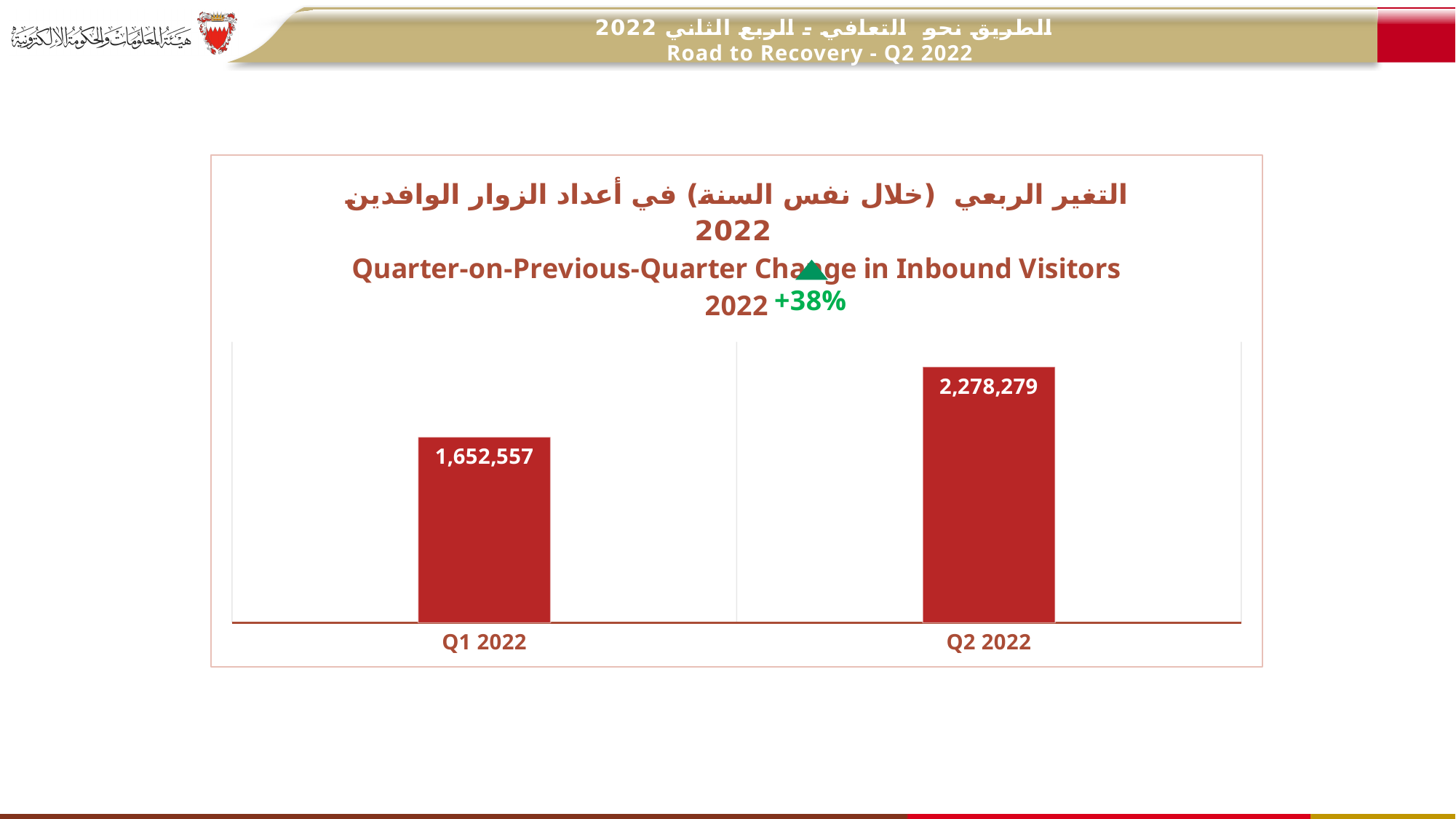
What kind of chart is shown on the slide? bar chart Which quarter has the lower number of inbound visitors? Q1 2022 How many bars are plotted in the chart? 2 Is the value for Q1 2022 larger or smaller than the value for Q2 2022? smaller What is the English title of the chart? Quarter-on-Previous-Quarter Change in Inbound Visitors 2022 What is the difference between the Q2 2022 and Q1 2022 values? 625,722 What is the value for Q1 2022? 1,652,557 Which quarter has the higher number of inbound visitors? Q2 2022 What is the value for Q2 2022? 2,278,279 Do the values rise or fall from Q1 2022 to Q2 2022? rise What percentage change is annotated on the chart? +38%